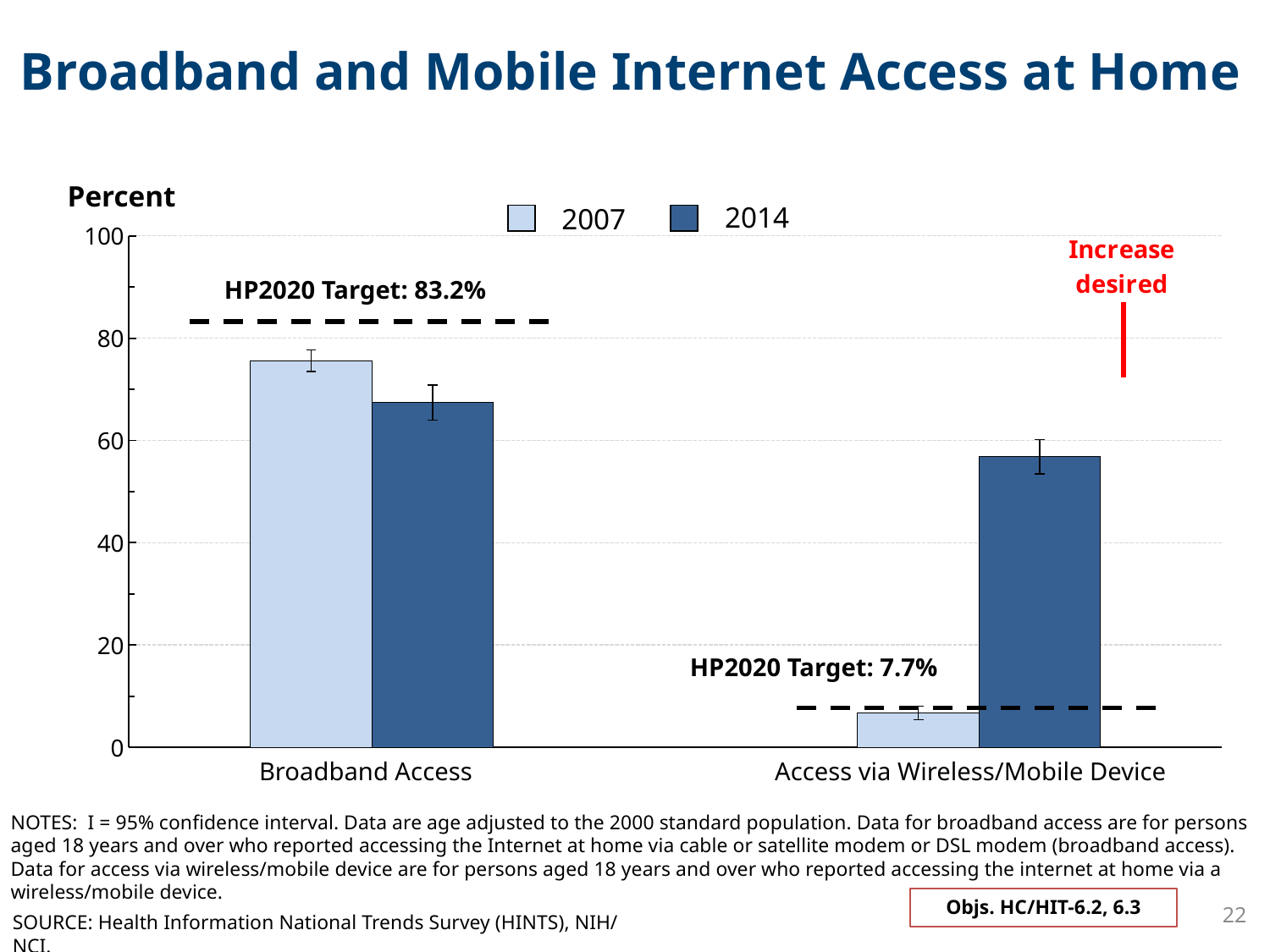
What is the title of the chart? Broadband and Mobile Internet Access at Home Is the 2014 value for Broadband Access greater or less than 80? less How many series does the legend list? 2 What is the HP2020 Target shown for Access via Wireless/Mobile Device? 7.7% What kind of chart is shown on the slide? bar chart Is the 2007 value for Access via Wireless/Mobile Device greater or less than 20? less How many categories are shown on the x axis? 2 For Broadband Access, which year has the larger value, 2007 or 2014? 2007 Is the 2007 value for Broadband Access greater or less than 60? greater What is the HP2020 Target shown for Broadband Access? 83.2% For Access via Wireless/Mobile Device, did the value rise or fall from 2007 to 2014? rise